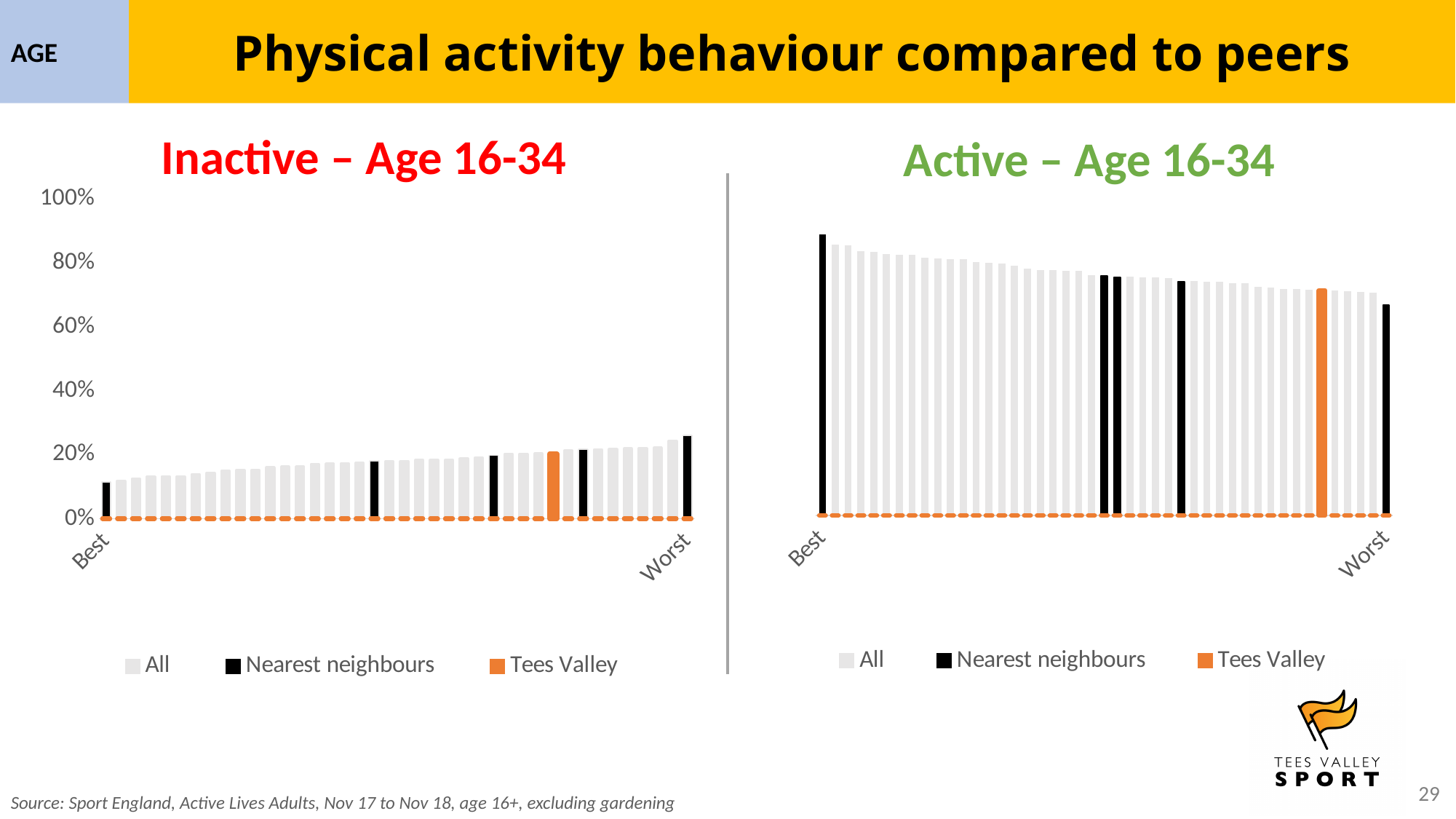
In the 'Active – Age 16-34' chart, which is larger: the Best (first) bar or the Tees Valley bar? the Best (first) bar Which series is shown in orange in the legend of the 'Inactive – Age 16-34' chart? Tees Valley In the 'Inactive – Age 16-34' chart, do the bar values rise or fall from Best to Worst? rise In the 'Inactive – Age 16-34' chart, is the value of the Worst (last) bar greater or less than 40%? less How many series does the legend of the 'Active – Age 16-34' chart list? 3 What is the highest value shown on the y axis of the 'Inactive – Age 16-34' chart? 100% In the 'Inactive – Age 16-34' chart, is the value for Tees Valley greater or less than 40%? less In the 'Active – Age 16-34' chart, is the value of the Best (first) bar greater or less than 80%? greater In the 'Active – Age 16-34' chart, do the bar values rise or fall from Best to Worst? fall What kind of chart is the 'Inactive – Age 16-34' chart? bar chart